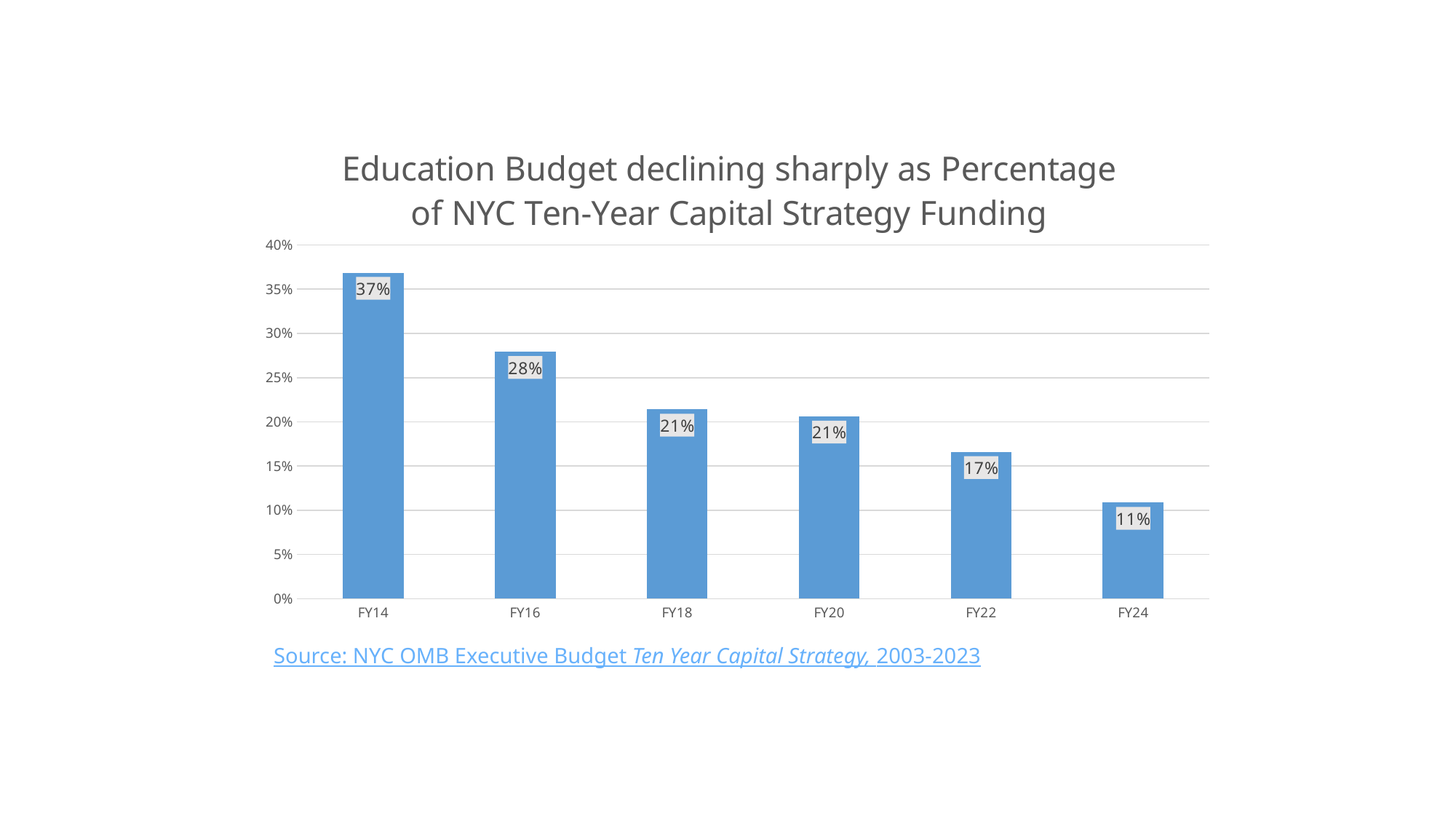
What is the value for FY24? 11% How many fiscal years are shown on the x axis? 6 What is the difference between the values for FY14 and FY24? 26% Which is larger, the value for FY16 or the value for FY20? FY16 What is the difference between the values for FY16 and FY22? 11% What is the value for FY14? 37% Which fiscal year has the highest value? FY14 Is the value for FY18 greater or less than 25%? less Which fiscal year has the lowest value? FY24 What kind of chart is shown on the slide? bar chart Do the values rise or fall from FY14 to FY24? fall What is the value for FY22? 17%